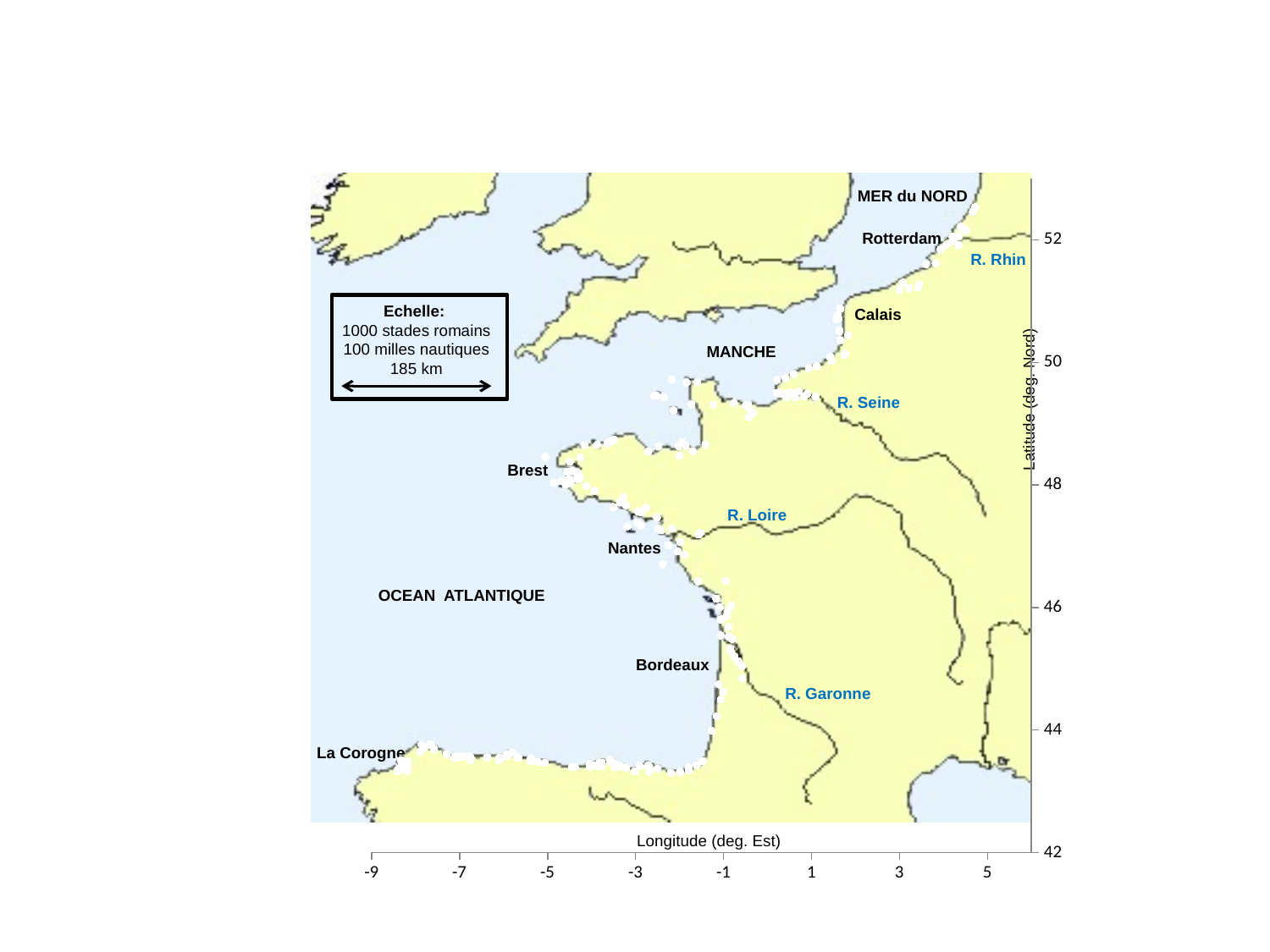
Is the latitude of La Corogne greater or less than 44? less Is the latitude of Calais greater or less than 50? greater What is the highest latitude tick shown on the vertical axis? 52 According to the scale box, how many kilometres correspond to 1000 stades romains? 185 km Which is further north on the map, Calais or Nantes? Calais What is the label of the horizontal axis? Longitude (deg. Est) According to the scale box, how many nautical miles correspond to 1000 stades romains? 100 milles nautiques What is the label of the vertical axis? Latitude (deg. Nord) Is the longitude of Brest greater or less than -3? less What kind of chart is shown on the slide? scatter plot over a map